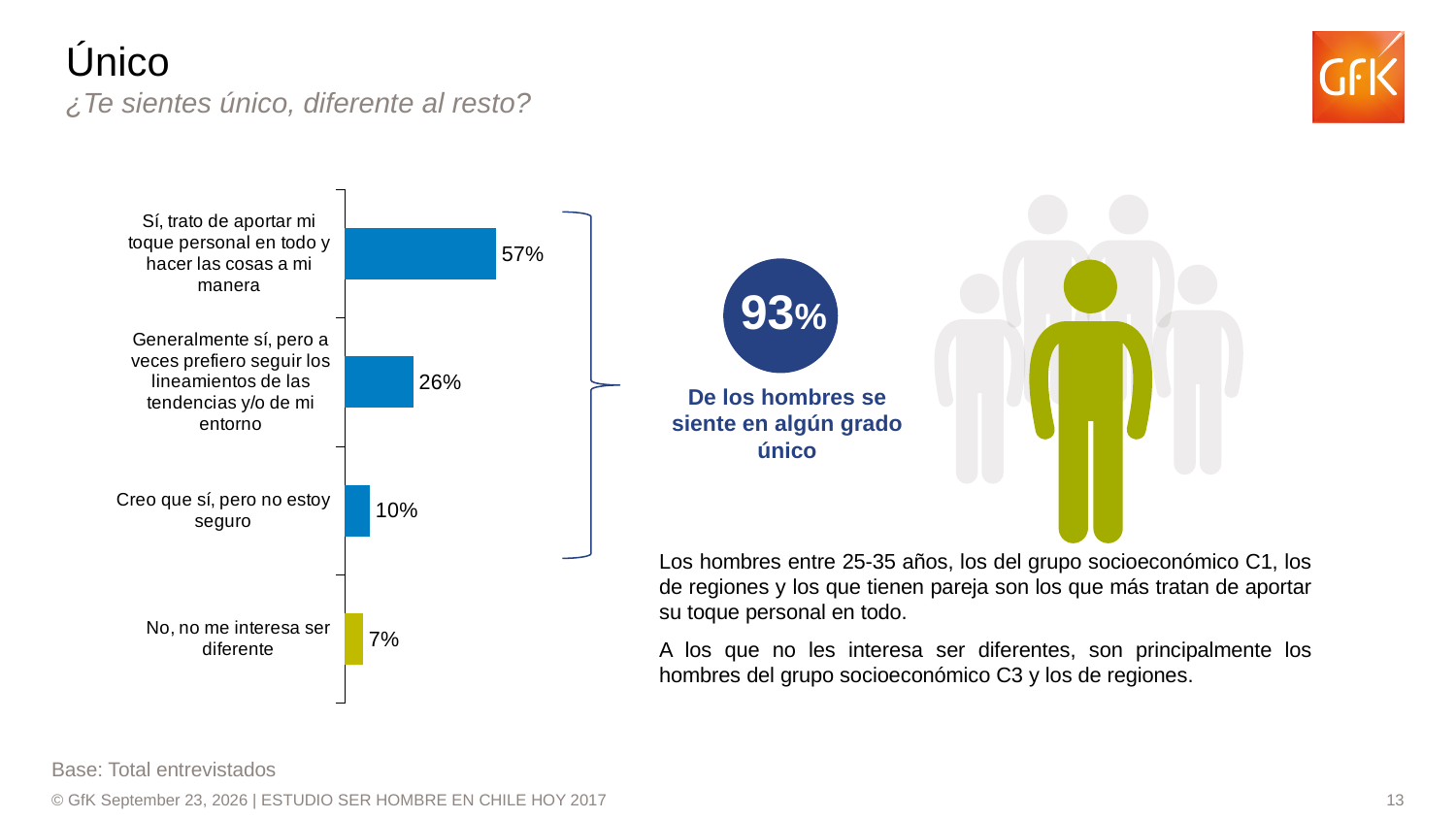
What is the combined total of the three categories grouped by the bracket (57%, 26% and 10%)? 93% Which category has the highest value in the bar chart? Sí, trato de aportar mi toque personal en todo y hacer las cosas a mi manera How many categories are shown in the bar chart? 4 What percentage is shown for "Sí, trato de aportar mi toque personal en todo y hacer las cosas a mi manera"? 57% What is the difference between the values for "Creo que sí, pero no estoy seguro" and "No, no me interesa ser diferente"? 3 percentage points What percentage is shown for "Generalmente sí, pero a veces prefiero seguir los lineamientos de las tendencias y/o de mi entorno"? 26% Which is larger: the value for "Generalmente sí..." or the value for "Creo que sí, pero no estoy seguro"? Generalmente sí, pero a veces prefiero seguir los lineamientos de las tendencias y/o de mi entorno What is the difference between the values for "Sí, trato de aportar mi toque personal..." and "Generalmente sí..."? 31 percentage points What percentage is shown for "No, no me interesa ser diferente"? 7% What kind of chart is shown on the slide? Bar chart What percentage is shown for "Creo que sí, pero no estoy seguro"? 10% Which category has the lowest value in the bar chart? No, no me interesa ser diferente